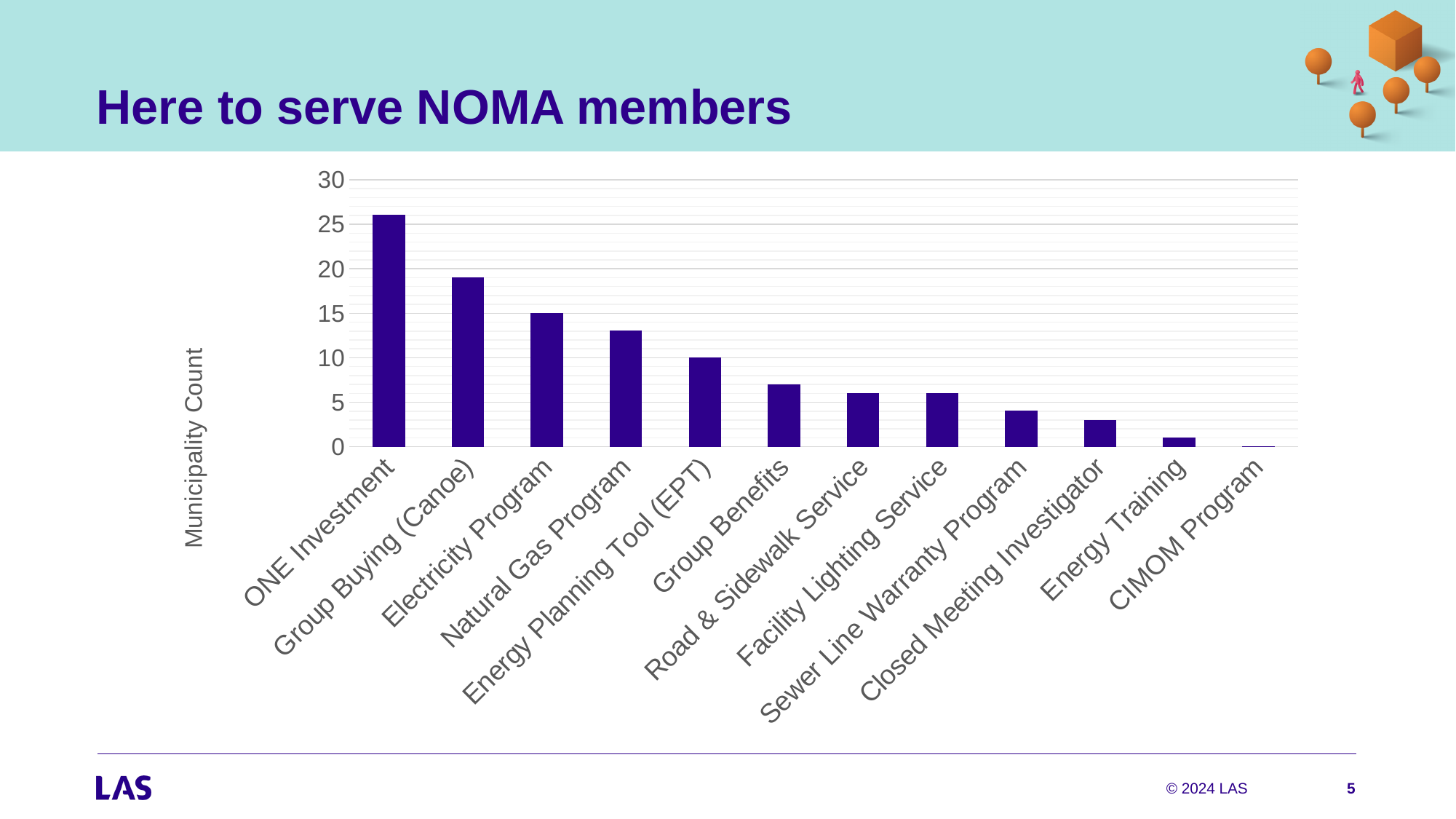
What is the municipality count for Electricity Program? 15 How many categories are plotted on the chart? 12 What is the municipality count for Energy Planning Tool (EPT)? 10 What kind of chart is shown on the slide? bar chart What is the label on the vertical axis of the chart? Municipality Count Which category has the lowest municipality count? CIMOM Program Do the values rise or fall moving from left to right along the x axis? fall Which has a larger municipality count, ONE Investment or Natural Gas Program? ONE Investment Which category has the highest municipality count? ONE Investment Is the value for Sewer Line Warranty Program greater or less than 5? less Is the value for ONE Investment greater or less than 25? greater Is the value for Group Buying (Canoe) greater or less than 20? less